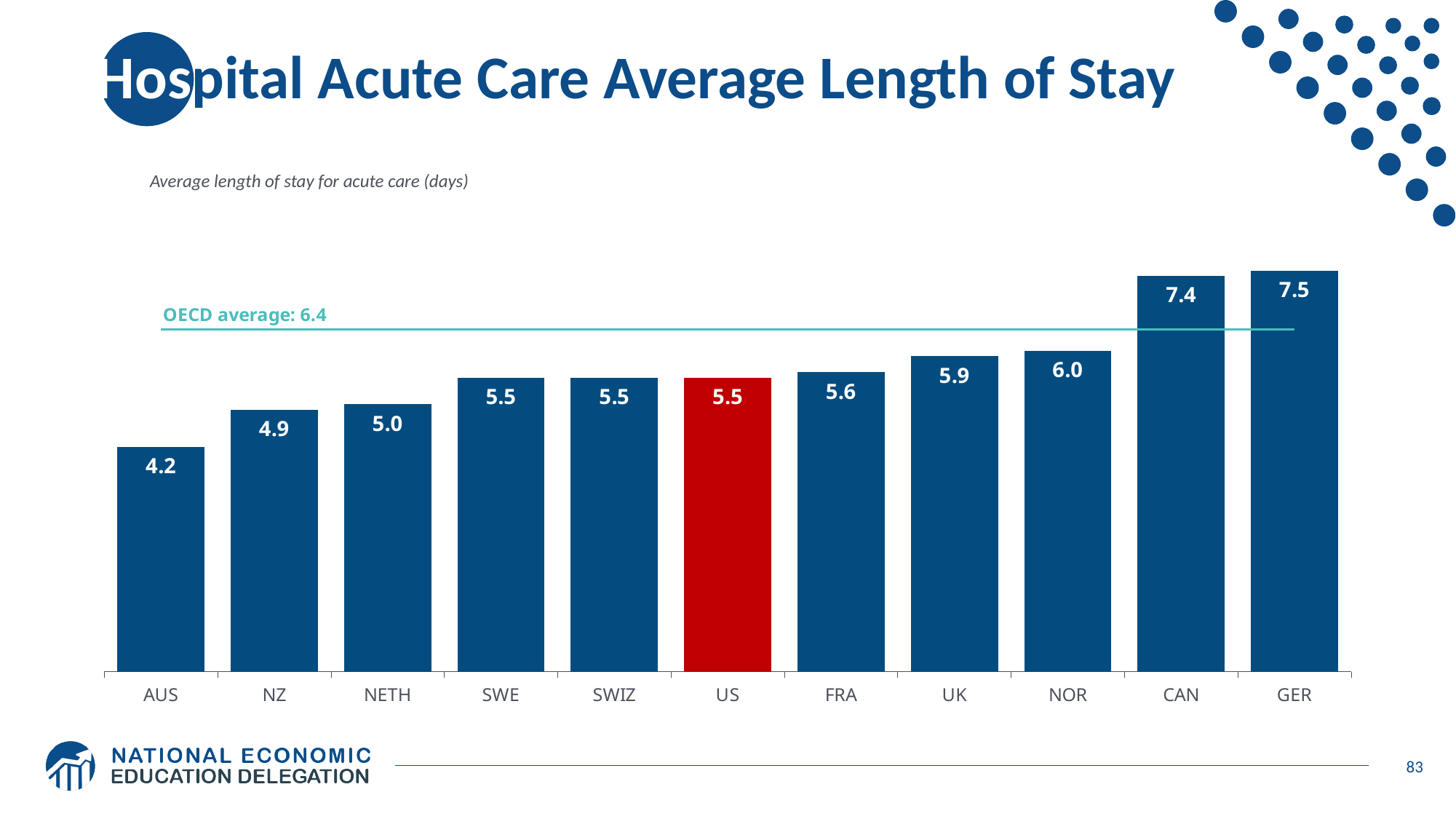
What is the average length of stay for acute care in AUS? 4.2 What is the difference in average length of stay between GER and AUS? 3.3 Which country has the highest average length of stay for acute care? GER What is the average length of stay for acute care in NOR? 6.0 What kind of chart is shown on the slide? Bar chart What is the average length of stay for acute care in the US? 5.5 What OECD average value is marked by the horizontal line on the chart? 6.4 Which has a longer average length of stay, UK or NETH? UK What is the difference in average length of stay between CAN and the US? 1.9 Do the values generally rise or fall from left to right across the countries? Rise Which country has the lowest average length of stay for acute care? AUS How many countries are shown in the chart? 11